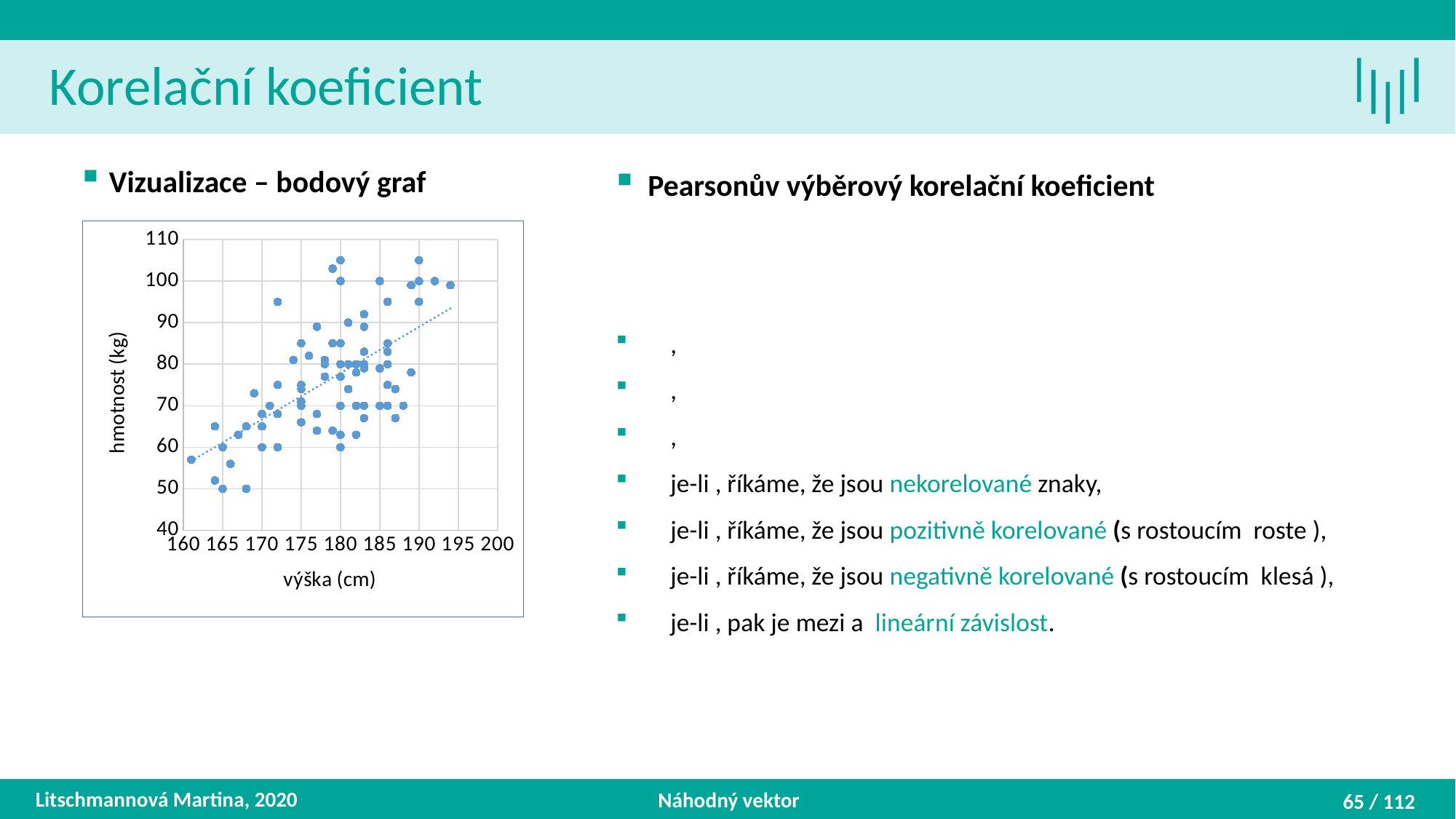
What kind of chart is shown on the slide? scatter plot Is the highest weight plotted in the scatter plot greater or less than 100? greater What is the label of the x axis of the scatter plot? výška (cm) Do the plotted weights generally rise or fall as height increases along the x axis? rise Is the lowest weight plotted in the scatter plot greater or less than 60? less What is the label of the y axis of the scatter plot? hmotnost (kg) What is the maximum value shown on the y axis of the scatter plot? 110 Does the dotted trend line in the scatter plot slope upward or downward? upward